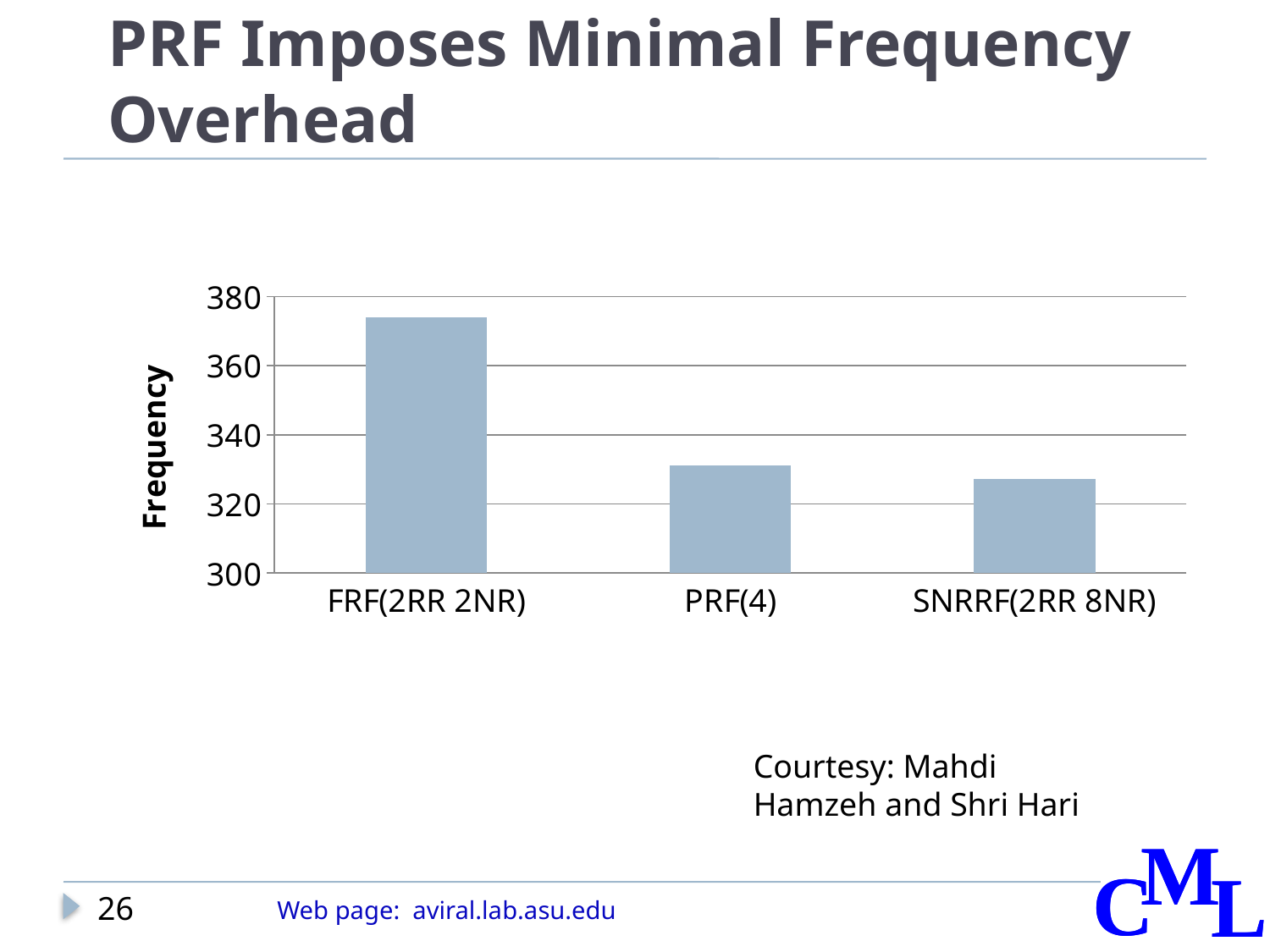
Do the frequency values rise or fall moving left to right across the categories? fall What is the label on the vertical axis of the chart? Frequency What is the title of the slide containing the chart? PRF Imposes Minimal Frequency Overhead Is the frequency for PRF(4) greater or less than 320? greater Is the frequency for FRF(2RR 2NR) greater or less than 360? greater Which category has the lowest frequency? SNRRF(2RR 8NR) Which category has the highest frequency? FRF(2RR 2NR) Is the frequency for PRF(4) greater or less than 340? less What kind of chart is shown on the slide? bar chart How many categories are plotted on the x axis of the chart? 3 Which has a higher frequency, FRF(2RR 2NR) or PRF(4)? FRF(2RR 2NR)